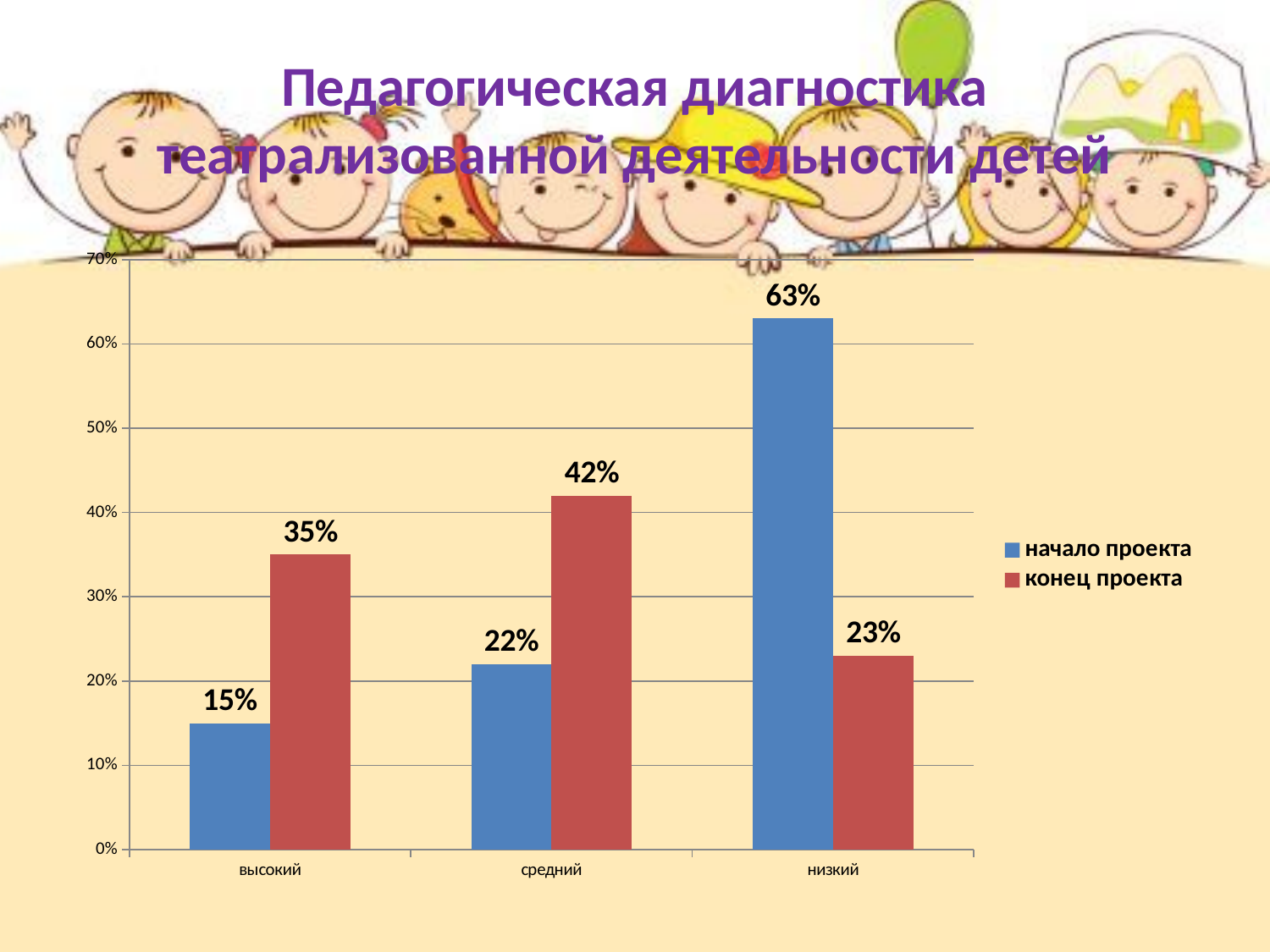
What is the value for "конец проекта" in the "средний" category? 42% What colour are the bars for "конец проекта"? red What is the value for "начало проекта" in the "высокий" category? 15% What is the value for "начало проекта" in the "низкий" category? 63% Which is larger in the "высокий" category: "начало проекта" or "конец проекта"? конец проекта Is the value for "конец проекта" in the "низкий" category greater or less than 30%? less How many series does the legend list? 2 What is the difference between "начало проекта" and "конец проекта" in the "низкий" category? 40% What kind of chart is shown on the slide? bar chart Which category has the highest value for "начало проекта"? низкий Which category has the lowest value for "конец проекта"? низкий How many categories are shown on the x axis? 3